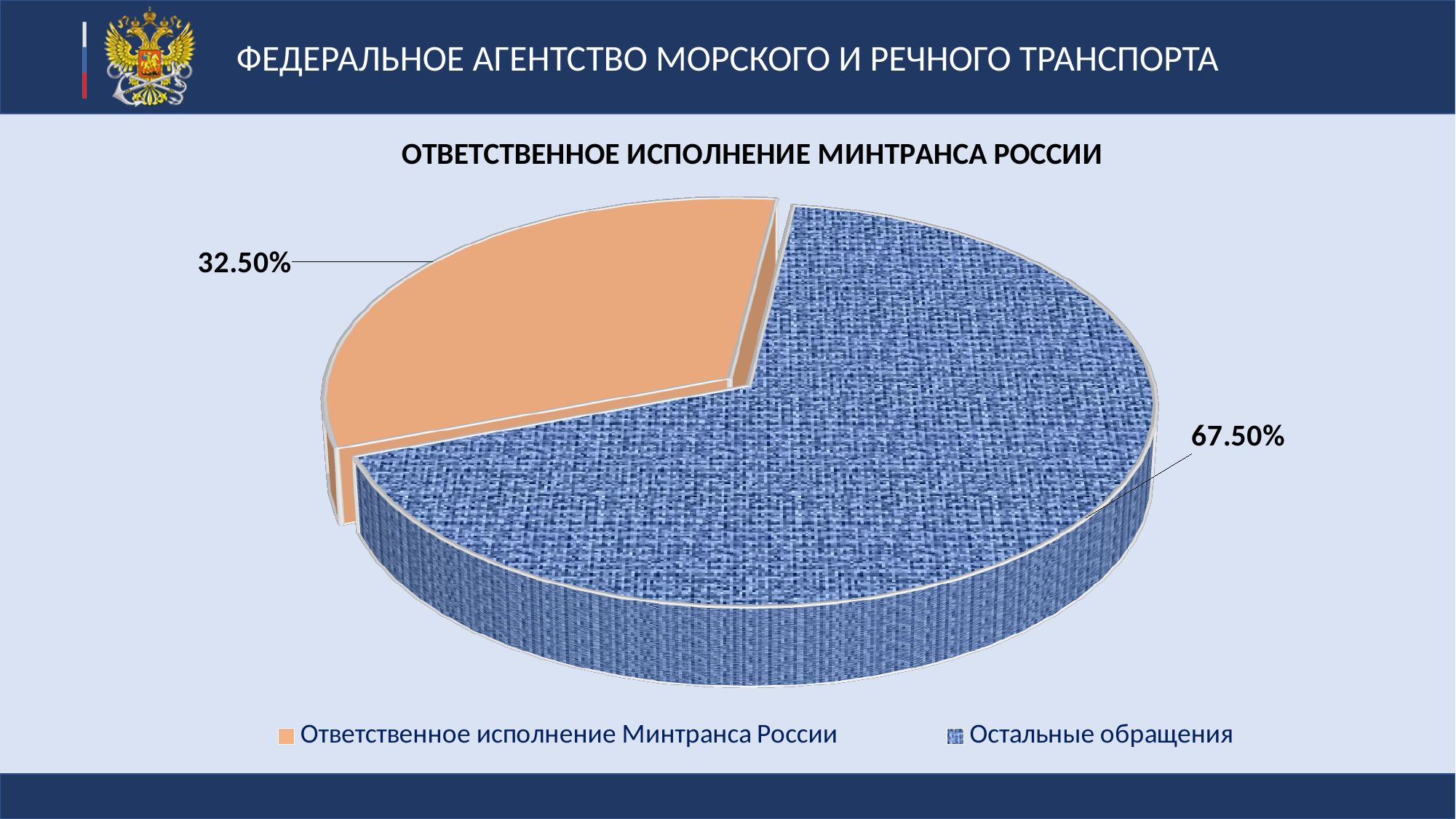
What share of the pie does "Остальные обращения" represent? 67.50% What kind of chart is shown on the slide? Pie chart What is the difference in percentage points between "Остальные обращения" and "Ответственное исполнение Минтранса России"? 35 percentage points What is the title of the chart? ОТВЕТСТВЕННОЕ ИСПОЛНЕНИЕ МИНТРАНСА РОССИИ Which is larger: the share for "Ответственное исполнение Минтранса России" or the share for "Остальные обращения"? Остальные обращения How many slices does the pie chart have? 2 What is the total of the two slices shown in the pie chart? 100% Which slice is the smallest in the pie chart? Ответственное исполнение Минтранса России What share of the pie does "Ответственное исполнение Минтранса России" represent? 32.50% How many entries does the legend list? 2 Which legend entry is shown in orange? Ответственное исполнение Минтранса России Which slice is the largest in the pie chart? Остальные обращения